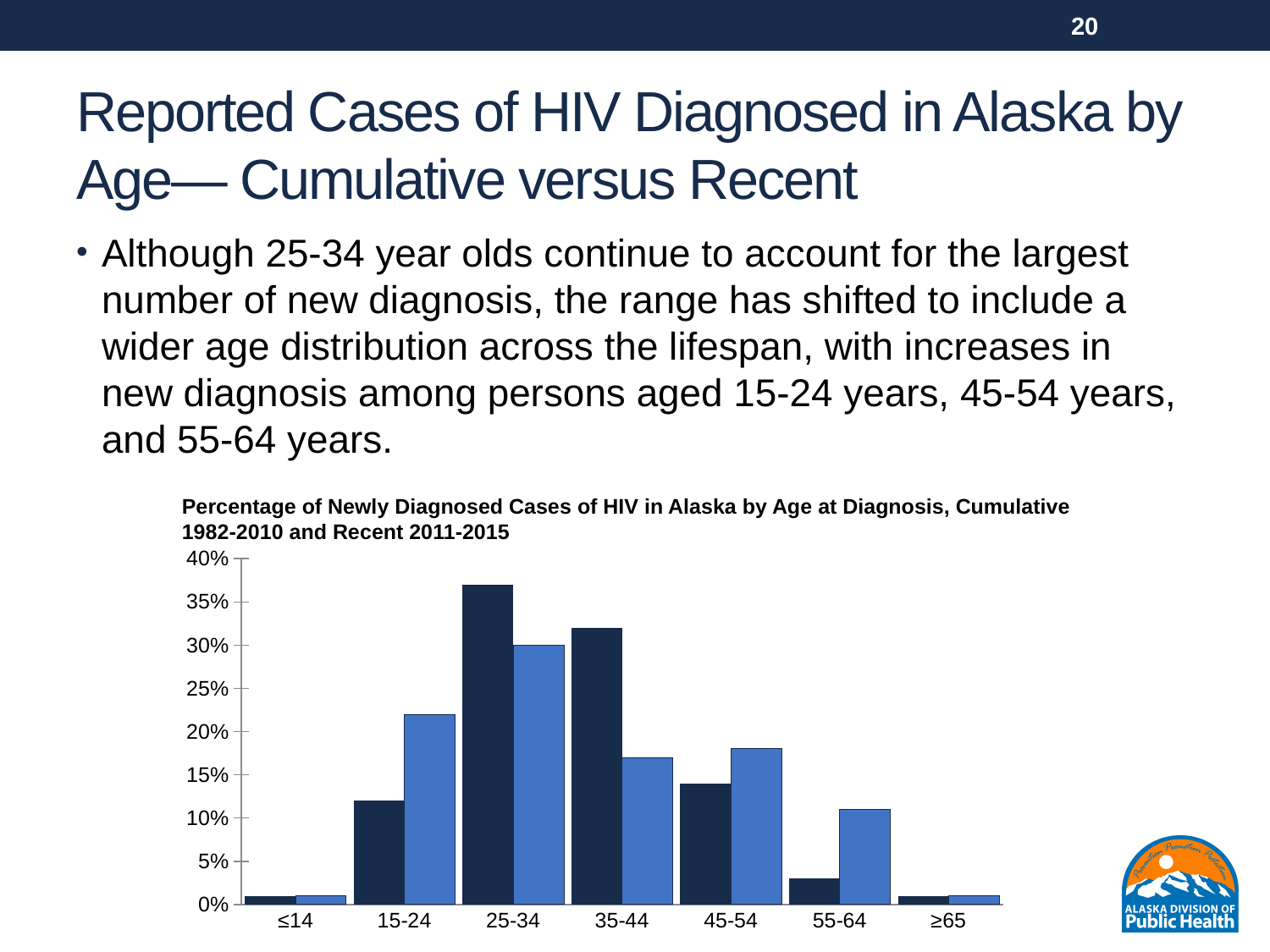
How many age categories are shown on the x axis of the chart? 7 Is the light blue bar for the 45-54 age group greater or less than 15%? greater Is the dark blue bar for the 55-64 age group greater or less than 5%? less Is the dark blue bar for the 25-34 age group greater or less than 35%? greater What is the highest percentage tick shown on the y axis of the chart? 40% Which age group has the tallest dark blue bar? 25-34 For the 15-24 age group, which bar is taller, the dark blue or the light blue? light blue For the 35-44 age group, which bar is taller, the dark blue or the light blue? dark blue Which age group has the tallest light blue bar? 25-34 What two time periods does the chart title say are compared? Cumulative 1982-2010 and Recent 2011-2015 What kind of chart is shown on the slide? bar chart